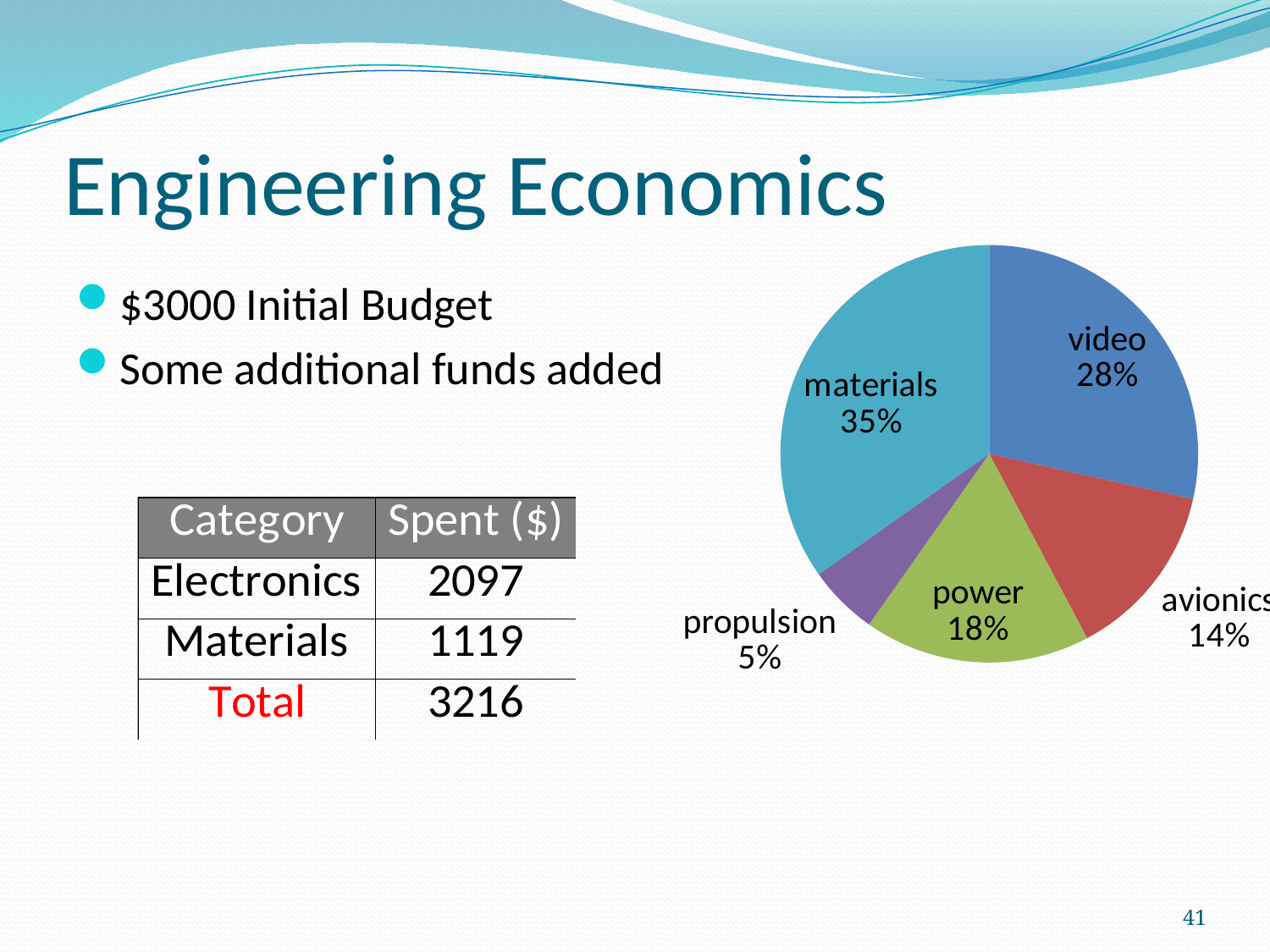
What is the difference in percentage points between the power slice and the propulsion slice? 13 What share of the pie does propulsion take? 5% What is the difference in percentage points between the materials slice and the video slice? 7 What kind of chart is shown on the slide? pie chart Which slice of the pie chart is the smallest? propulsion Which slice of the pie chart is the largest? materials What share of the pie does video take? 28% What share of the pie does power take? 18% Which slice is larger, power or avionics? power How many slices does the pie chart have? 5 What colour is the materials slice in the pie chart? teal